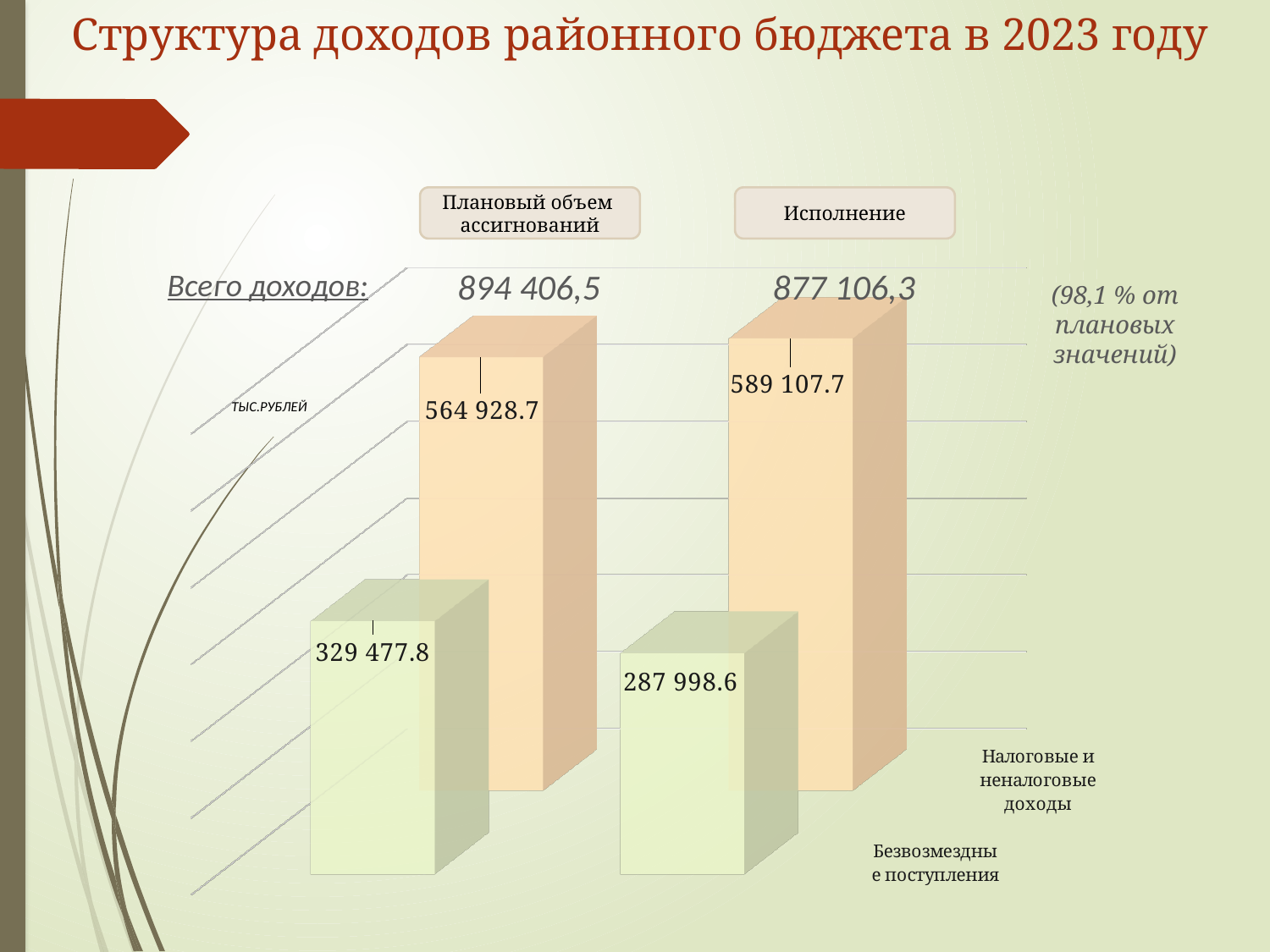
Which bar on the chart has the lowest value? Безвозмездные поступления, Исполнение Which bar on the chart has the highest value? Налоговые и неналоговые доходы, Исполнение What is the value of Налоговые и неналоговые доходы for Плановый объем ассигнований? 564 928.7 What is the difference between Безвозмездные поступления for Плановый объем ассигнований and for Исполнение? 41 479.2 What is the value of Налоговые и неналоговые доходы for Исполнение? 589 107.7 What type of chart is shown on the slide? Bar chart Which is larger: Безвозмездные поступления for Плановый объем ассигнований or for Исполнение? Плановый объем ассигнований What is the total income (Всего доходов) shown for Исполнение? 877 106,3 What is the difference between Налоговые и неналоговые доходы for Исполнение and for Плановый объем ассигнований? 24 179.0 What is the value of Безвозмездные поступления for Исполнение? 287 998.6 What is the value of Безвозмездные поступления for Плановый объем ассигнований? 329 477.8 How many categories are shown on the x axis of the chart? 2